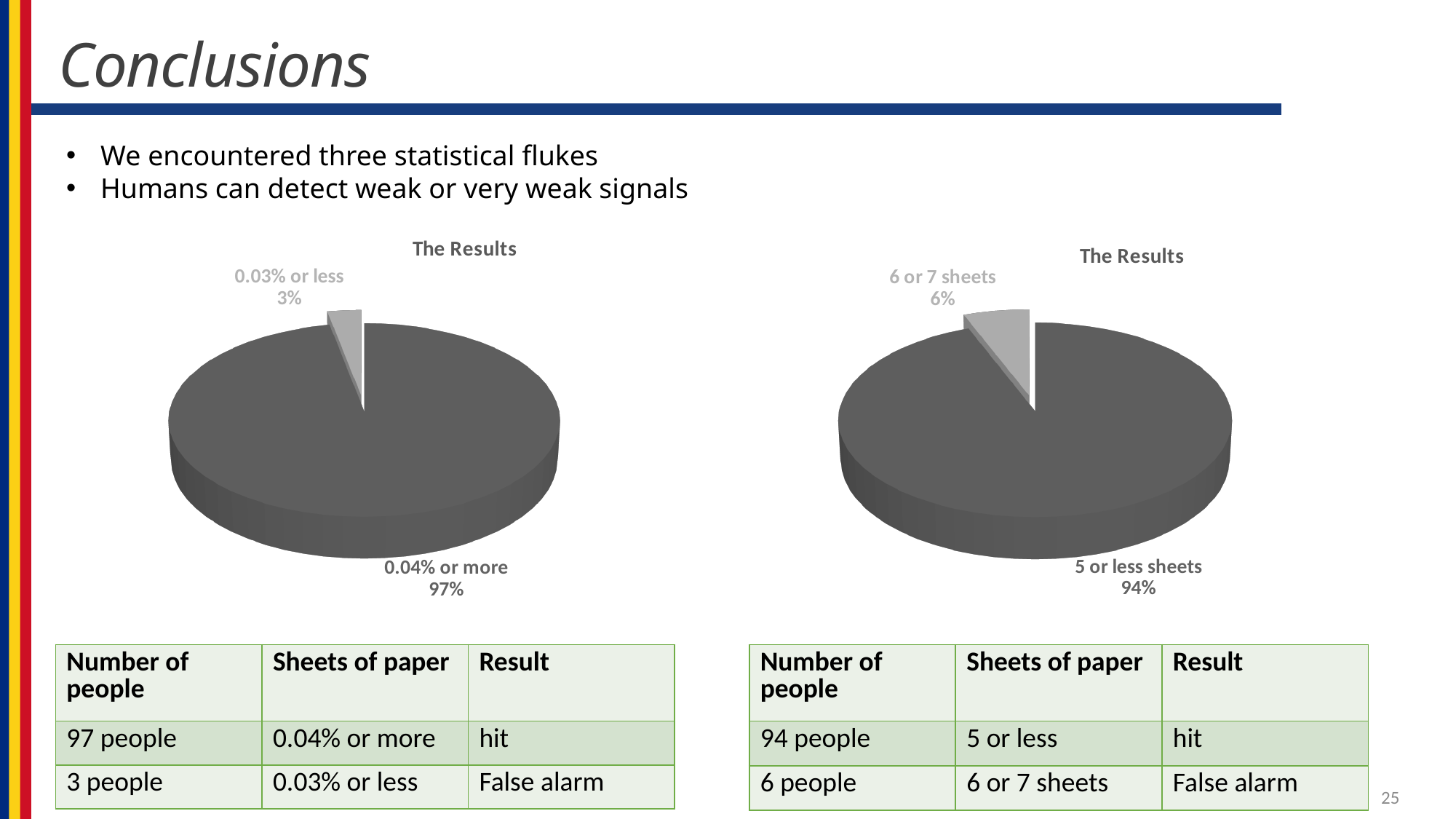
What is the title of the left pie chart? The Results In the left pie chart, what share does the '0.03% or less' slice have? 3% In the right pie chart, what share does the '5 or less sheets' slice have? 94% How many slices does the left pie chart have? 2 Which is larger: the '6 or 7 sheets' slice in the right pie chart or the '0.03% or less' slice in the left pie chart? 6 or 7 sheets In the right pie chart, which slice is the smallest? 6 or 7 sheets In the left pie chart, what is the difference in percentage points between the '0.04% or more' and '0.03% or less' slices? 94 percentage points In the right pie chart, what share does the '6 or 7 sheets' slice have? 6% What type of chart is shown on the right side of the slide? Pie chart In the left pie chart, which slice is the largest? 0.04% or more In the right pie chart, what is the difference in percentage points between the '5 or less sheets' and '6 or 7 sheets' slices? 88 percentage points